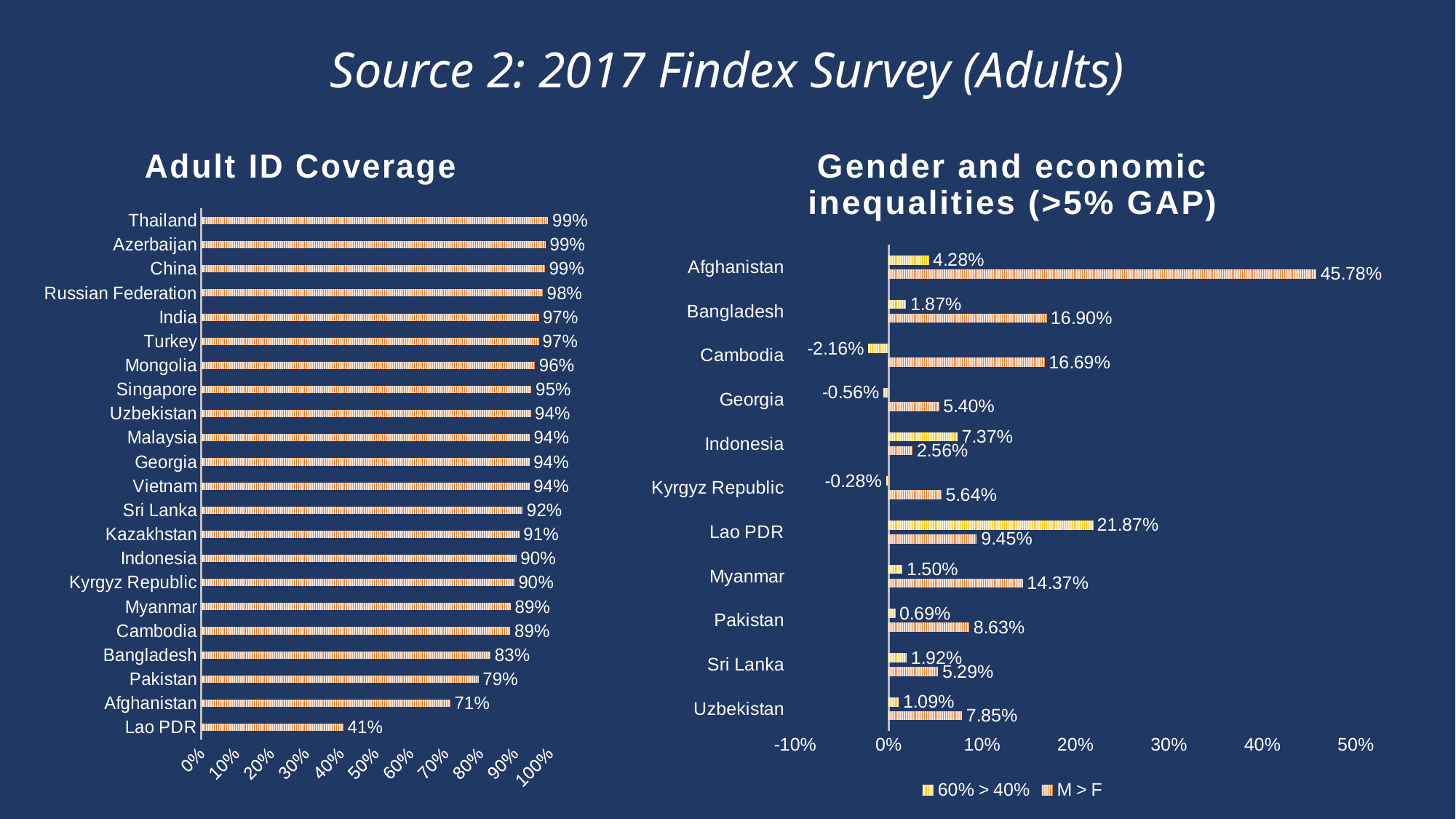
In the Gender and economic inequalities chart, what is the difference between the M > F values for Bangladesh and Cambodia? 0.21% In the Gender and economic inequalities chart, what is the M > F value for Afghanistan? 45.78% In the Adult ID Coverage chart, what is the value for Lao PDR? 41% In the Adult ID Coverage chart, which is larger, Bangladesh or Cambodia? Cambodia In the Adult ID Coverage chart, which country has the lowest coverage? Lao PDR In the Gender and economic inequalities chart, how many series does the legend list? 2 In the Gender and economic inequalities chart, how many countries are shown? 11 In the Adult ID Coverage chart, what is the difference between Pakistan and Afghanistan? 8% In the Adult ID Coverage chart, how many countries are listed? 22 What kind of chart is the Gender and economic inequalities chart? Bar chart In the Gender and economic inequalities chart, what is the 60% > 40% value for Cambodia? -2.16% In the Gender and economic inequalities chart, which country has the highest 60% > 40% value? Lao PDR